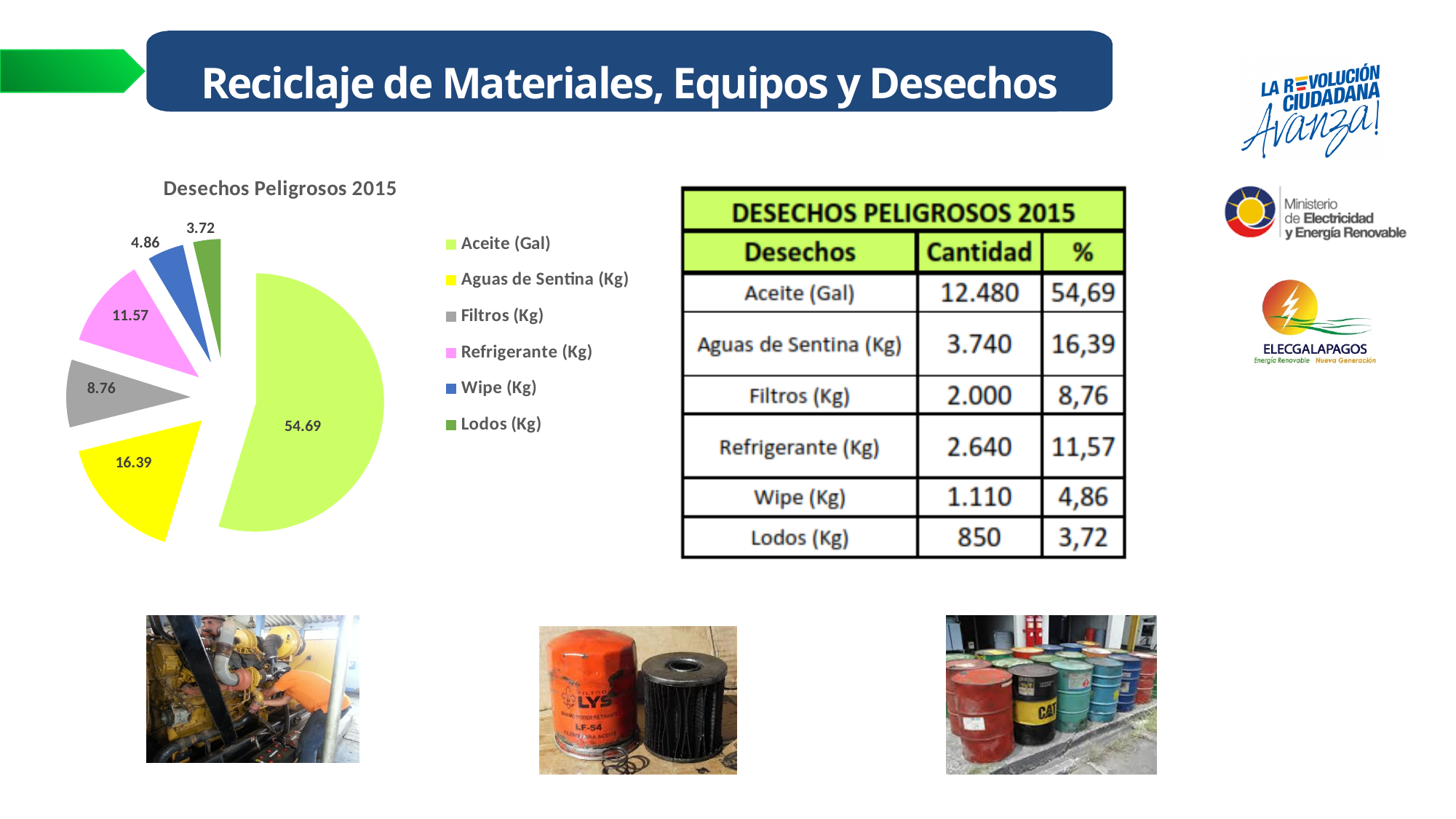
How many slices does the pie chart have? 6 What is the value shown for Wipe (Kg) in the pie chart? 4.86 What type of chart is shown under the title "Desechos Peligrosos 2015"? Pie chart Which category has the smallest slice in the pie chart? Lodos (Kg) How many entries does the legend of the pie chart list? 6 What is the difference between the values for Aguas de Sentina (Kg) and Filtros (Kg) in the pie chart? 7.63 What is the title of the pie chart? Desechos Peligrosos 2015 Which is larger in the pie chart, Refrigerante (Kg) or Filtros (Kg)? Refrigerante (Kg) What is the value shown for Refrigerante (Kg) in the pie chart? 11.57 What is the value shown for Aceite (Gal) in the pie chart? 54.69 What colour is the Aguas de Sentina (Kg) slice in the pie chart? Yellow Which category has the largest slice in the pie chart? Aceite (Gal)